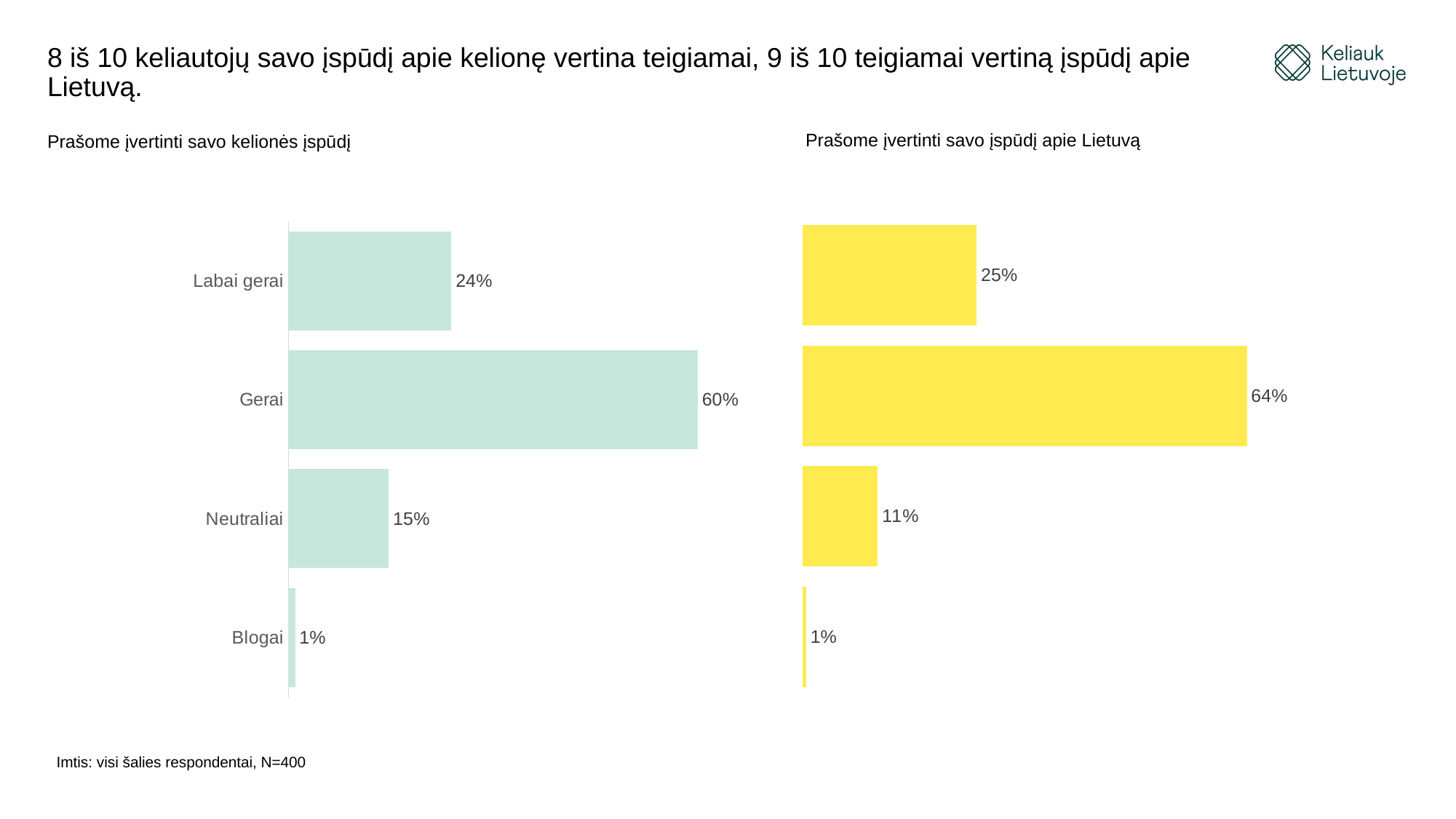
In the left chart 'Prašome įvertinti savo kelionės įspūdį', which category has the lowest value? Blogai In the left chart 'Prašome įvertinti savo kelionės įspūdį', what is the value for Neutraliai? 15% In the left chart 'Prašome įvertinti savo kelionės įspūdį', what is the value for Gerai? 60% In the right chart 'Prašome įvertinti savo įspūdį apie Lietuvą', what is the difference between Labai gerai and Neutraliai? 14% In the right chart 'Prašome įvertinti savo įspūdį apie Lietuvą', what is the value for Neutraliai? 11% In the left chart 'Prašome įvertinti savo kelionės įspūdį', what is the difference between Gerai and Labai gerai? 36% In the right chart 'Prašome įvertinti savo įspūdį apie Lietuvą', which category has the highest value? Gerai How many categories does the left chart 'Prašome įvertinti savo kelionės įspūdį' show? 4 What colour are the bars in the right chart 'Prašome įvertinti savo įspūdį apie Lietuvą'? Yellow Which is larger: Gerai in the left chart or Gerai in the right chart? Gerai in the right chart In the right chart 'Prašome įvertinti savo įspūdį apie Lietuvą', what is the value for Labai gerai? 25% What kind of chart is the right chart 'Prašome įvertinti savo įspūdį apie Lietuvą'? Bar chart